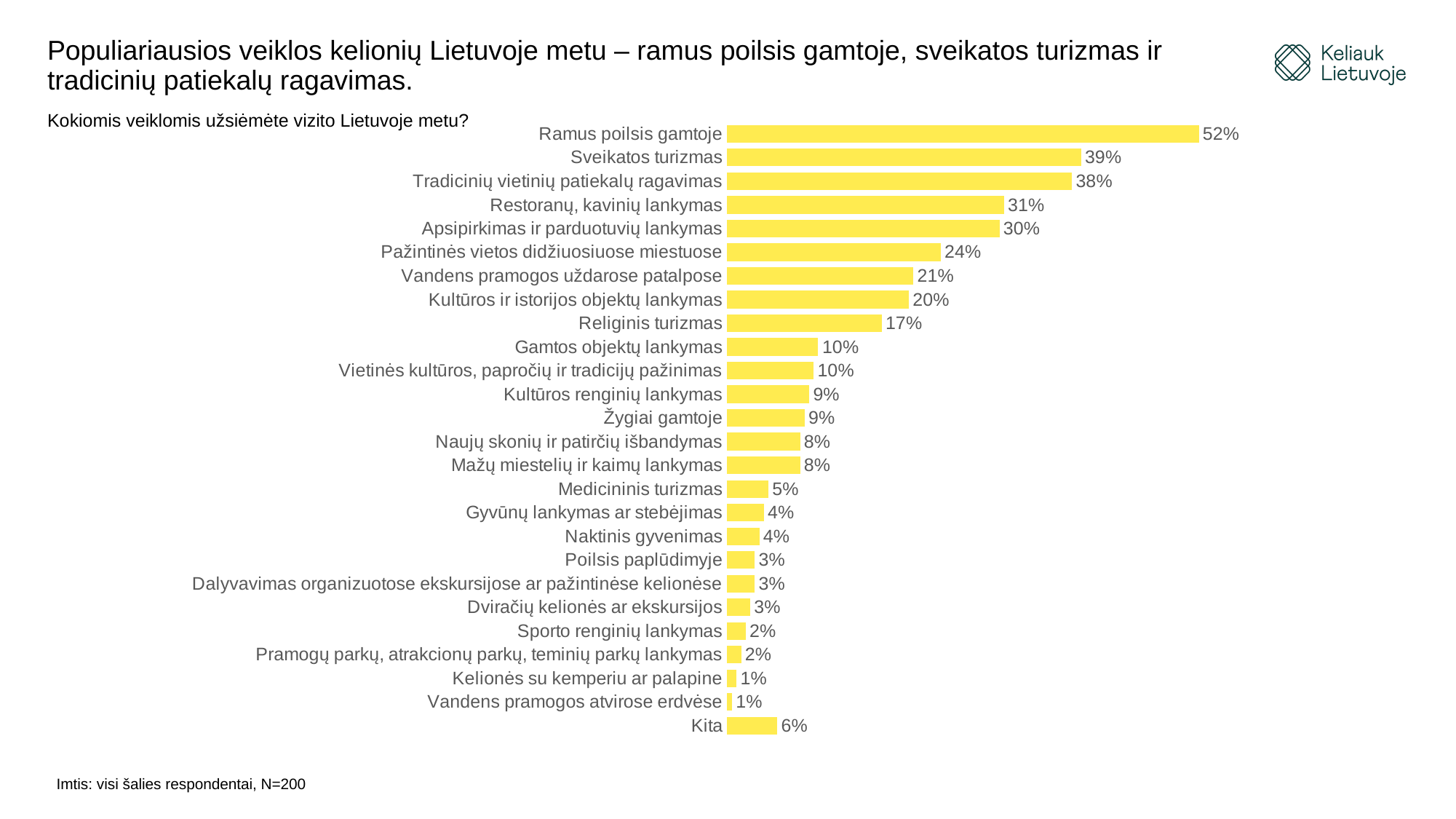
Which is larger, Pažintinės vietos didžiuosiuose miestuose or Kultūros ir istorijos objektų lankymas? Pažintinės vietos didžiuosiuose miestuose How many categories are shown in the chart? 26 What is the difference between Sveikatos turizmas and Tradicinių vietinių patiekalų ragavimas? 1% Which is larger, Naktinis gyvenimas or Kita? Kita Which activity has the highest value? Ramus poilsis gamtoje What is the value for Kita? 6% What is the difference between Ramus poilsis gamtoje and Restoranų, kavinių lankymas? 21% What is the value for Religinis turizmas? 17% What is the value for Ramus poilsis gamtoje? 52% What is the sample size stated on the slide? N=200 What is the value for Medicininis turizmas? 5% What kind of chart is shown on the slide? Bar chart